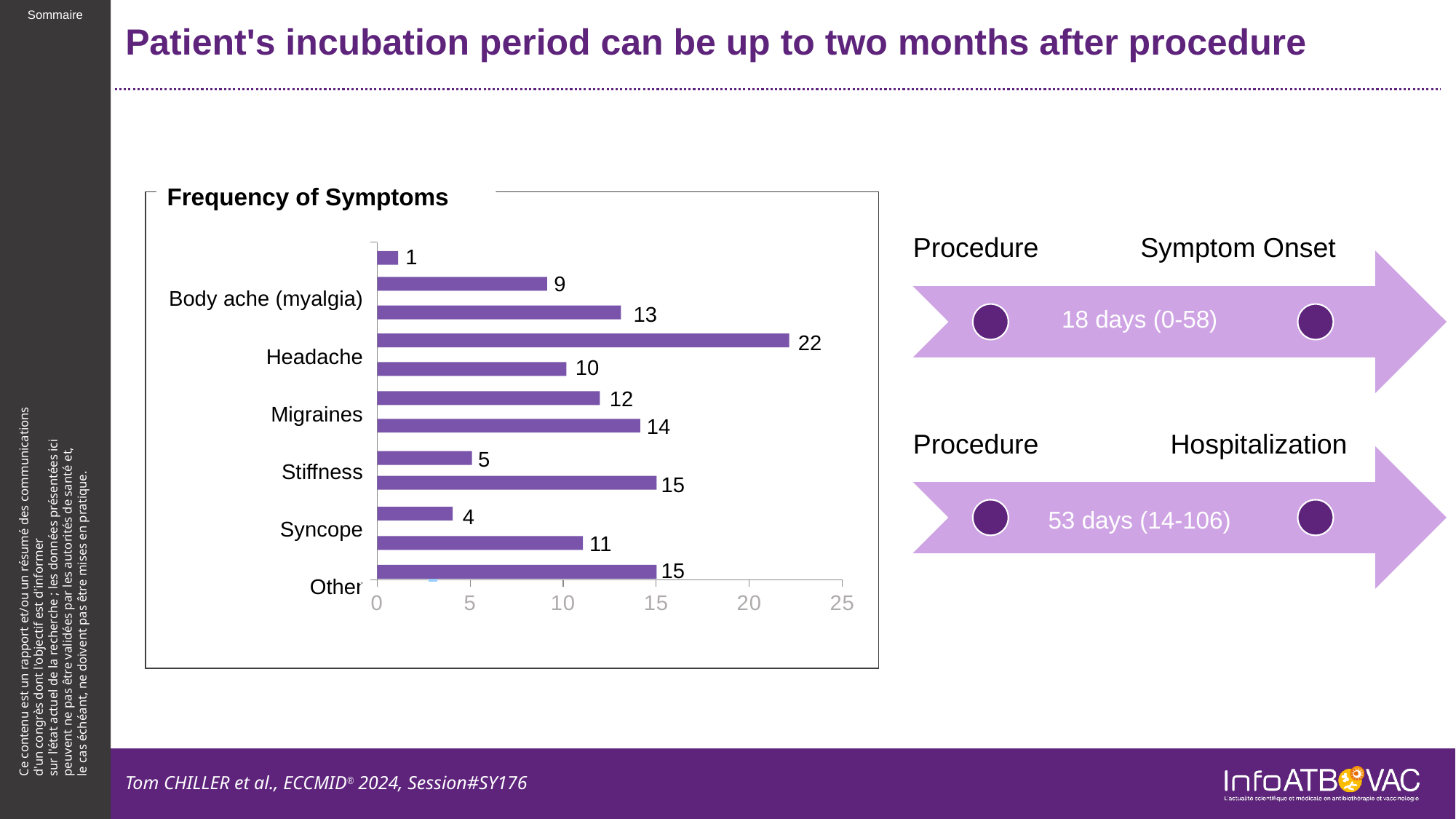
What is the title of the chart on the slide? Frequency of Symptoms How many bars in the Frequency of Symptoms chart have the value 15? 2 What kind of chart is shown under the title "Frequency of Symptoms"? bar chart What is the maximum value shown on the horizontal axis of the Frequency of Symptoms chart? 25 What is the value of the top-most bar in the Frequency of Symptoms chart? 1 What is the lowest value shown by any bar in the Frequency of Symptoms chart? 1 How many bars are plotted in the Frequency of Symptoms chart? 12 What is the value of the bottom-most bar (next to the "Other" label) in the Frequency of Symptoms chart? 15 Is the longest bar in the Frequency of Symptoms chart greater or less than 20? greater What is the highest value shown by any bar in the Frequency of Symptoms chart? 22 Which is larger in the Frequency of Symptoms chart: the bar labelled 22 or the bar labelled 14? 22 What is the difference between the largest bar value (22) and the smallest bar value (1) in the Frequency of Symptoms chart? 21